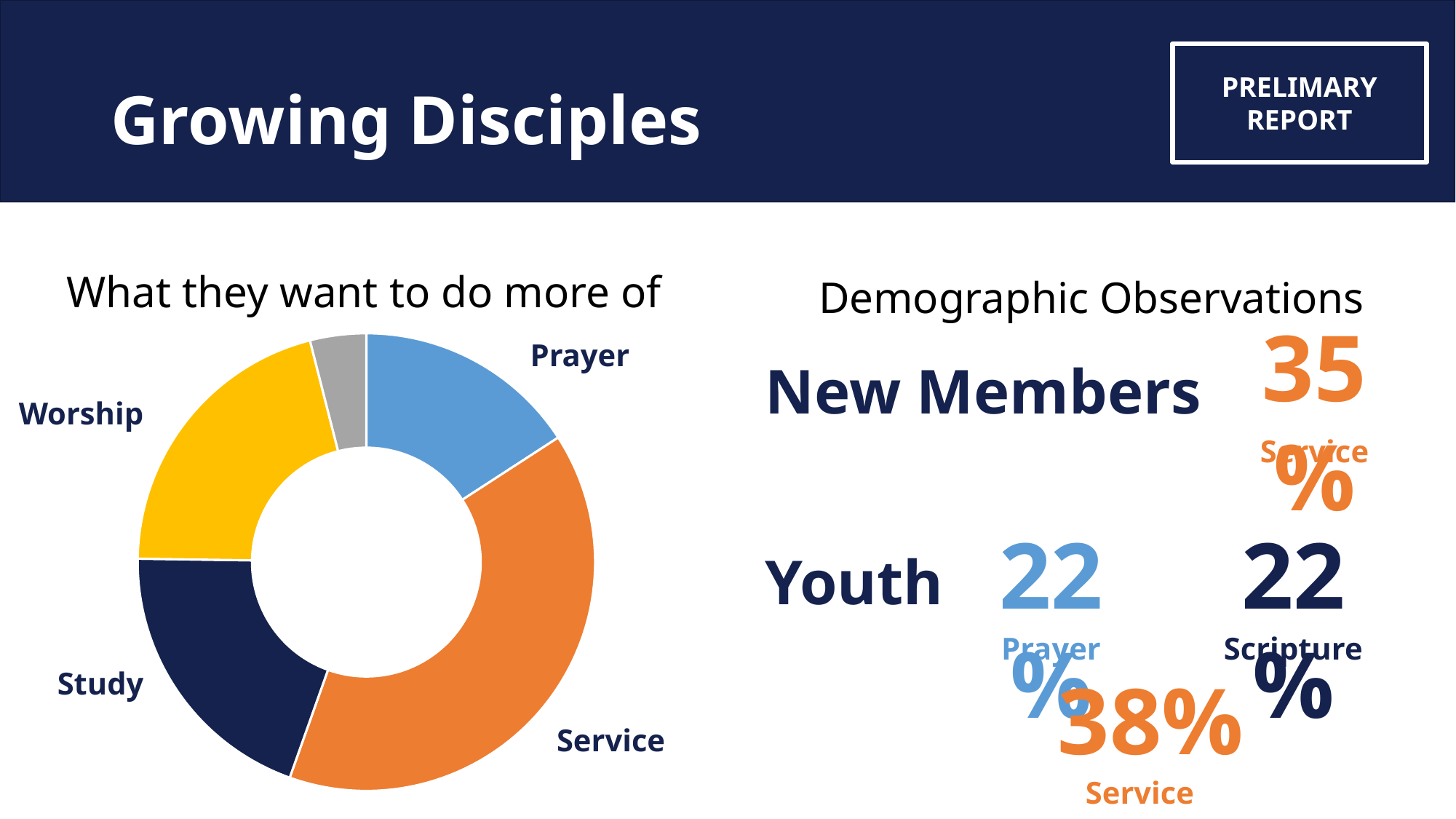
What colour is the Service slice in the "What they want to do more of" chart? Orange What is the title of the doughnut chart on the slide? What they want to do more of In the "What they want to do more of" chart, which slice is larger, Service or Study? Service In the "What they want to do more of" chart, which slice is larger, Worship or Prayer? Worship In the "What they want to do more of" chart, which slice is larger, Service or Worship? Service What kind of chart is shown under "What they want to do more of"? Doughnut (pie) chart How many labelled categories does the "What they want to do more of" chart show? 4 Which category has the largest slice in the "What they want to do more of" chart? Service